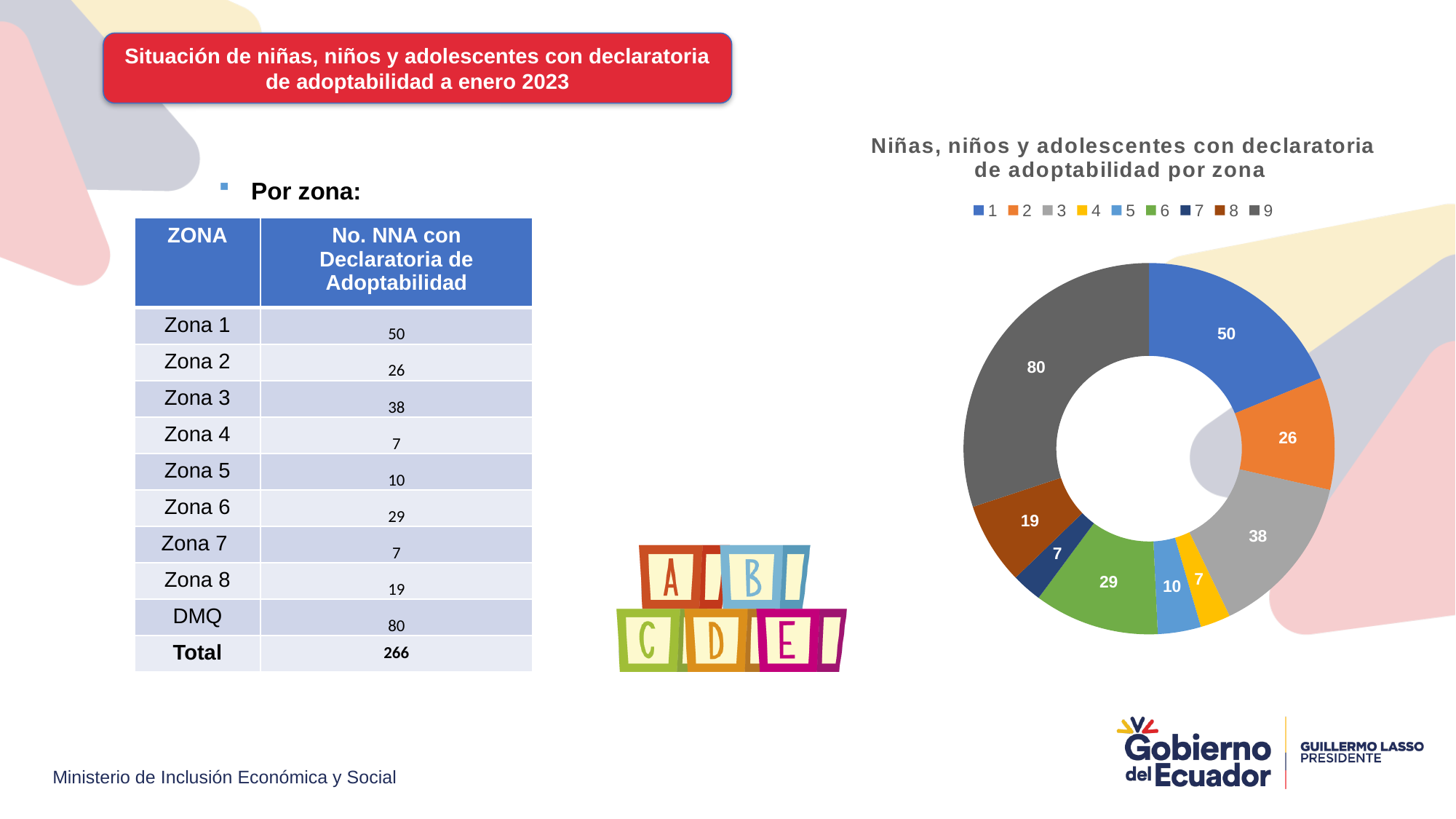
What is the value of the slice for category 6? 29 What is the value of the slice for category 3? 38 What is the total of all the slice values in the chart? 266 What is the value of the slice for category 9? 80 What is the difference between the values for category 9 and category 1? 30 How many entries does the chart legend list? 9 Which categories share the smallest value in the chart? 4 and 7 Which category has the largest slice in the chart? 9 Which is larger, the value for category 2 or the value for category 6? Category 6 How many slices does the doughnut chart have? 9 What kind of chart is shown on the slide? Doughnut (pie) chart What is the title of the chart? Niñas, niños y adolescentes con declaratoria de adoptabilidad por zona